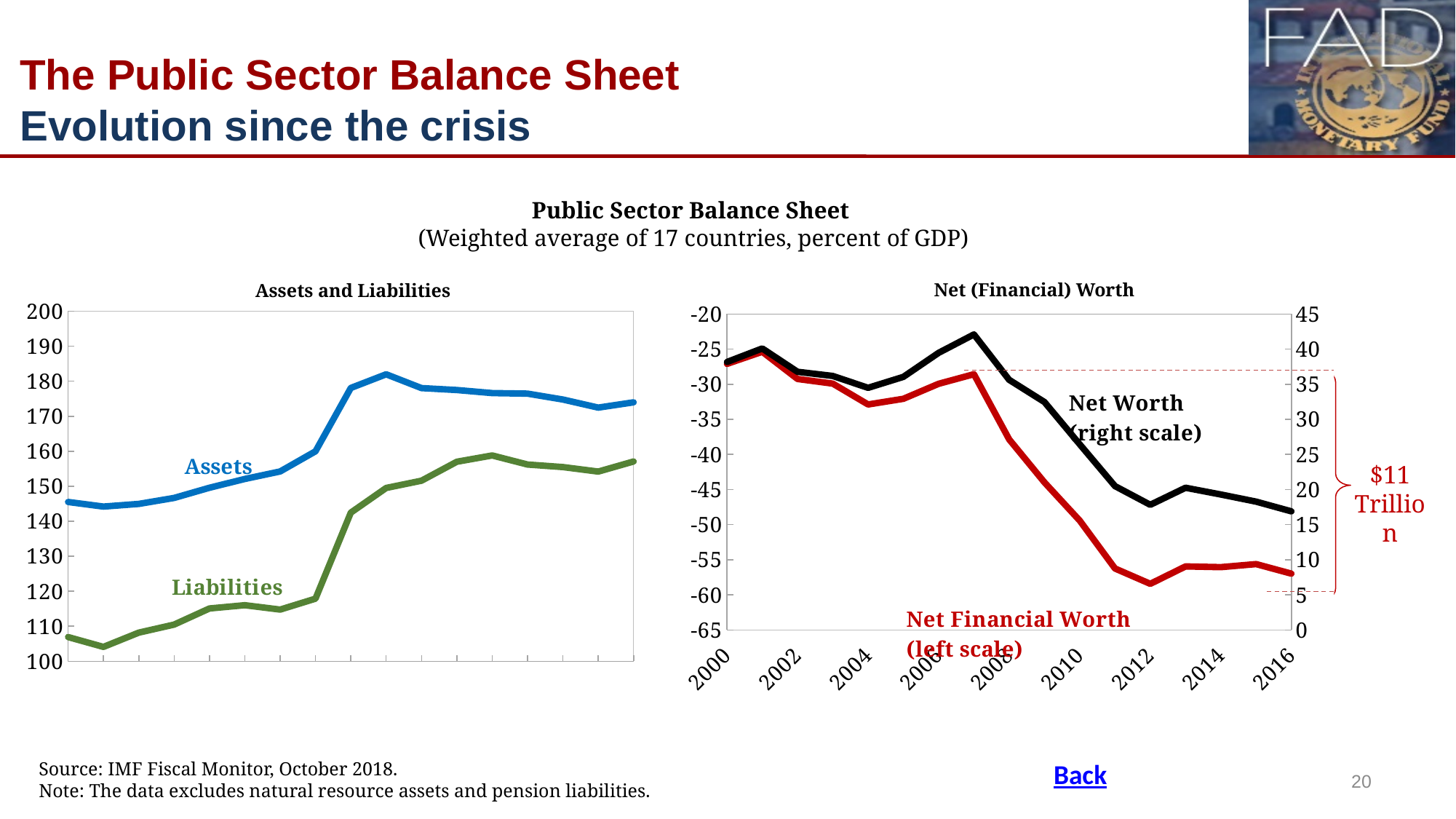
How many series are plotted on the 'Assets and Liabilities' chart? 2 On the 'Assets and Liabilities' chart, is the highest value of Liabilities greater or less than 150? greater On the 'Net (Financial) Worth' chart, which series is plotted against the right scale? Net Worth On the 'Net (Financial) Worth' chart, does Net Financial Worth rise or fall between 2008 and 2012? fall On the 'Assets and Liabilities' chart, is the lowest value of Assets greater or less than 130? greater On the 'Net (Financial) Worth' chart, is the Net Worth value (right scale) in 2007 greater or less than 40? greater On the 'Assets and Liabilities' chart, which series is higher throughout, Assets or Liabilities? Assets What amount is written next to the bracket on the right side of the 'Net (Financial) Worth' chart? $11 Trillion What kind of chart is the 'Assets and Liabilities' chart on the left? line chart